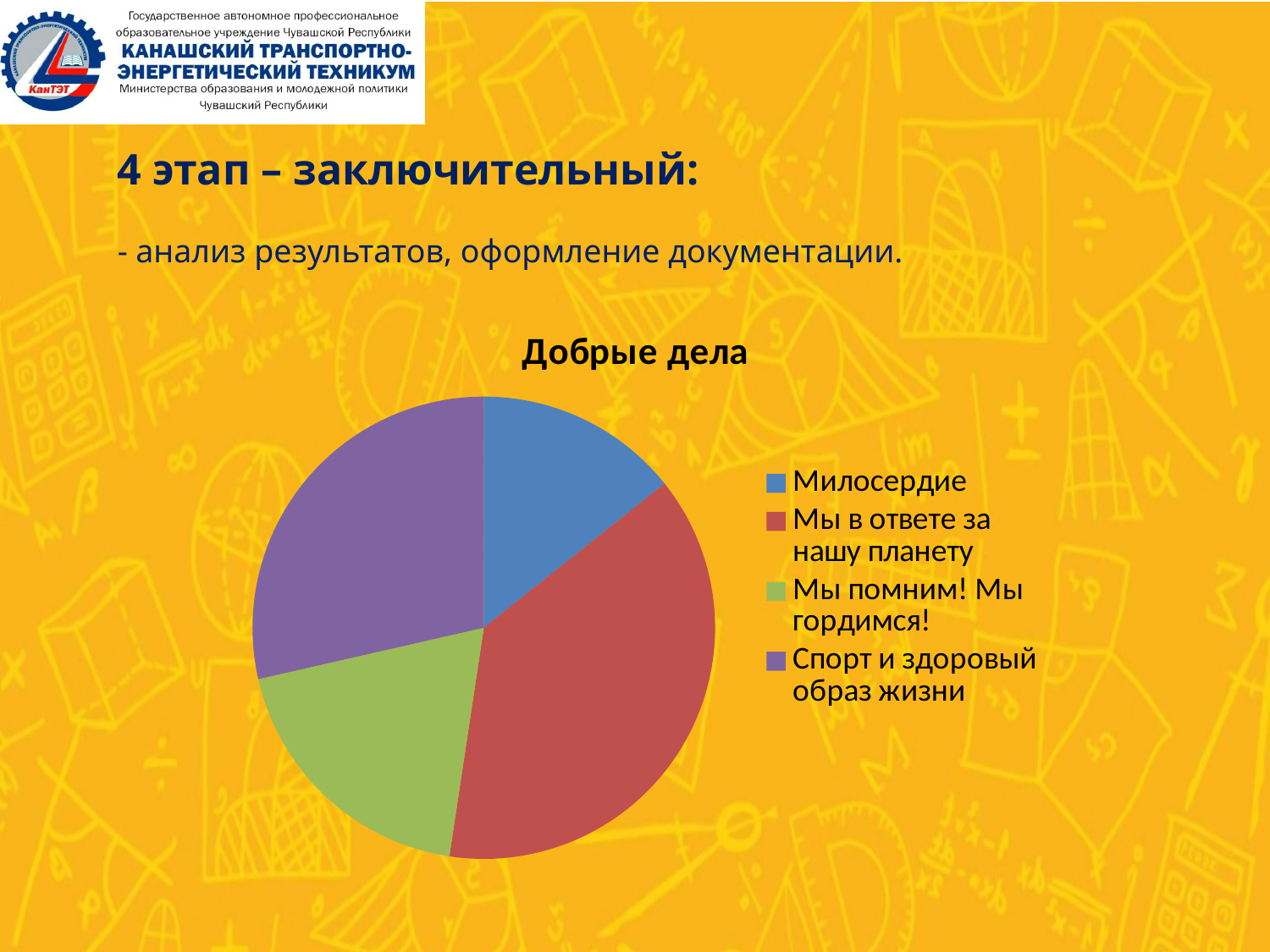
What kind of chart is shown on the slide? pie chart Which slice is larger: Спорт и здоровый образ жизни or Мы помним! Мы гордимся!? Спорт и здоровый образ жизни What colour is the slice for Милосердие? blue Which slice is larger: Мы в ответе за нашу планету or Милосердие? Мы в ответе за нашу планету Which category has the largest slice of the pie? Мы в ответе за нашу планету Which category has the smallest slice of the pie? Милосердие What is the title of the chart? Добрые дела How many entries does the legend list? 4 Which slice is larger: Мы помним! Мы гордимся! or Милосердие? Мы помним! Мы гордимся! How many slices does the pie chart have? 4